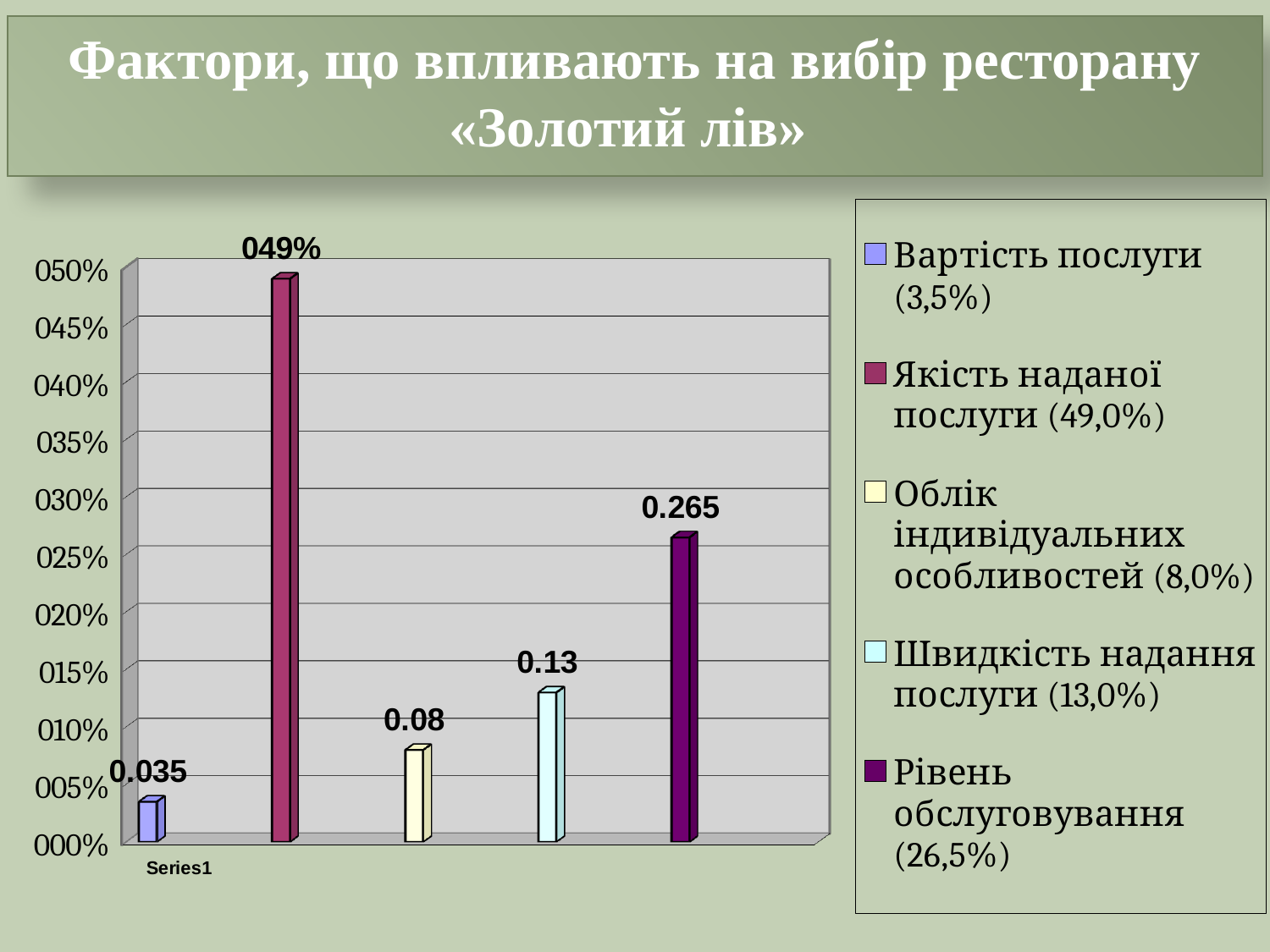
Which is larger, the bar for Швидкість надання послуги or the bar for Облік індивідуальних особливостей? Швидкість надання послуги What value is labelled on the bar for Рівень обслуговування? 0.265 Is the value for Рівень обслуговування greater or less than 020%? greater What value is labelled on the bar for Швидкість надання послуги? 0.13 What label appears under the bars on the x axis? Series1 Which factor has the shortest bar? Вартість послуги What value is labelled on the bar for Вартість послуги? 0.035 What value is labelled on the bar for Якість наданої послуги? 049% How many bars are plotted in the chart? 5 What kind of chart is shown on the slide? bar chart Which factor has the tallest bar? Якість наданої послуги What is the difference between the labelled values for Рівень обслуговування (0.265) and Швидкість надання послуги (0.13)? 0.135